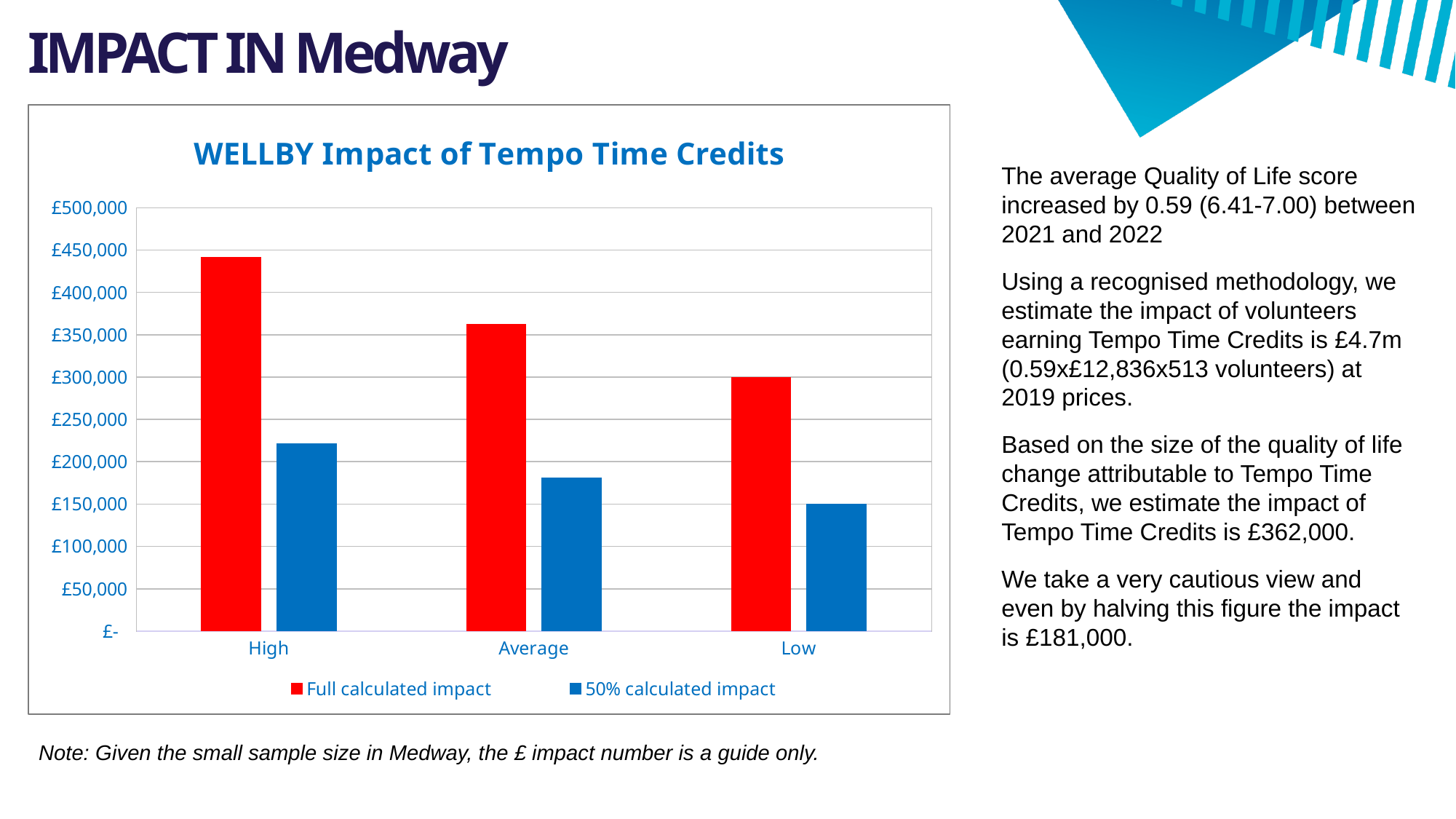
Is the Full calculated impact for Average greater or less than £400,000? less What type of chart is shown on the slide? bar chart Which category has the lowest 50% calculated impact? Low How many categories are shown on the x axis of the chart? 3 Which colour represents the 50% calculated impact series in the chart? blue Which is larger: the Full calculated impact for Average or the Full calculated impact for Low? Average How many series does the chart legend list? 2 What is the title of the chart? WELLBY Impact of Tempo Time Credits Is the 50% calculated impact for Average greater or less than £200,000? less Which category has the highest Full calculated impact? High Is the Full calculated impact for High greater or less than £400,000? greater Do the Full calculated impact values rise or fall from High to Low along the x axis? fall